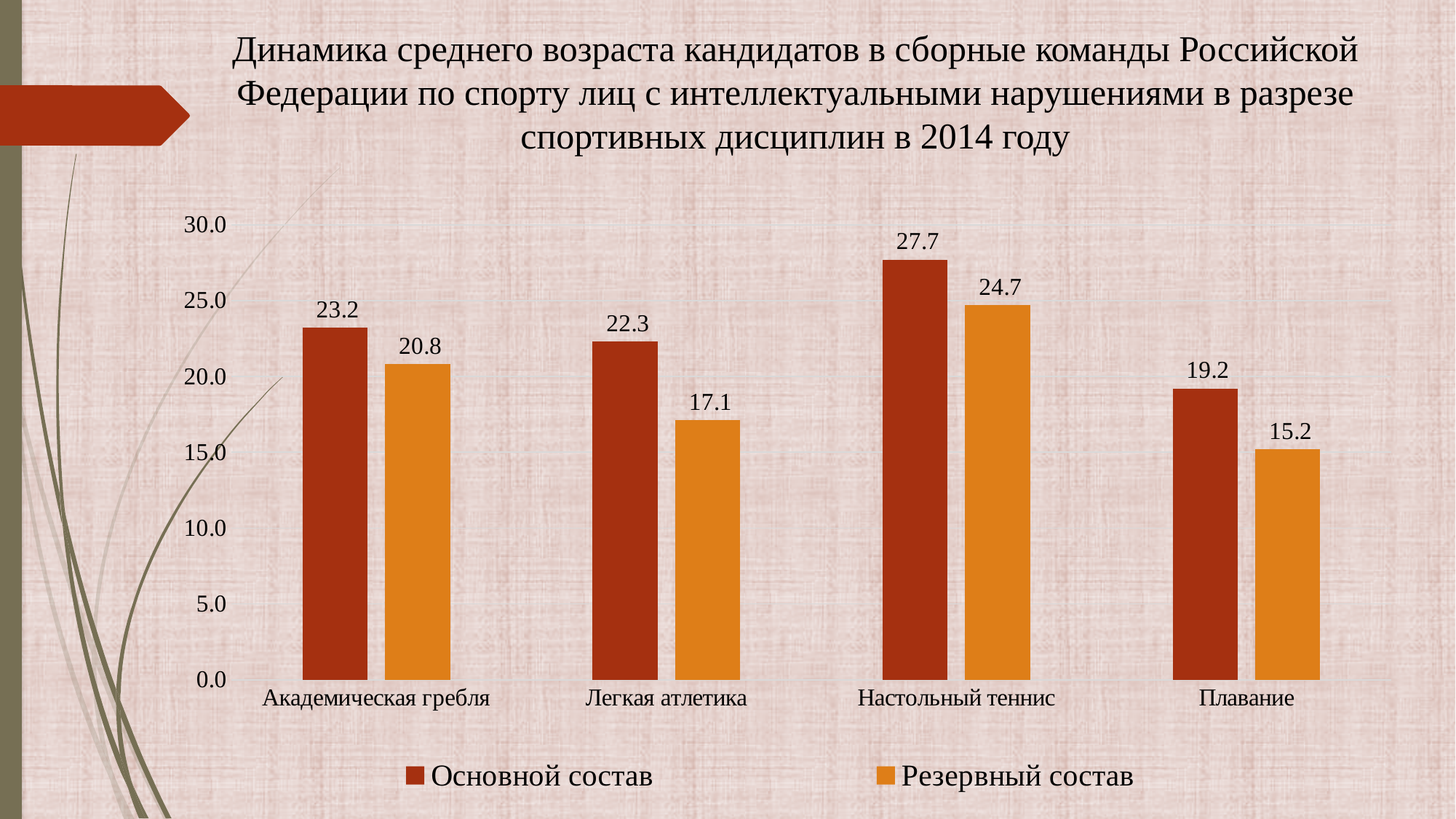
Which is larger in Академическая гребля: Основной состав or Резервный состав? Основной состав What colour are the bars for Резервный состав? Orange Which sport has the lowest value for Резервный состав? Плавание What is the value for Резервный состав in Легкая атлетика? 17.1 What is the value for Основной состав in Настольный теннис? 27.7 What kind of chart is shown on the slide? Bar chart Which sport has the highest value for Основной состав? Настольный теннис What is the value for Резервный состав in Плавание? 15.2 How many sports are shown on the x axis? 4 Is the value for Резервный состав in Настольный теннис greater or less than 20.0? greater What is the difference between Основной состав and Резервный состав in Легкая атлетика? 5.2 How many series does the legend list? 2